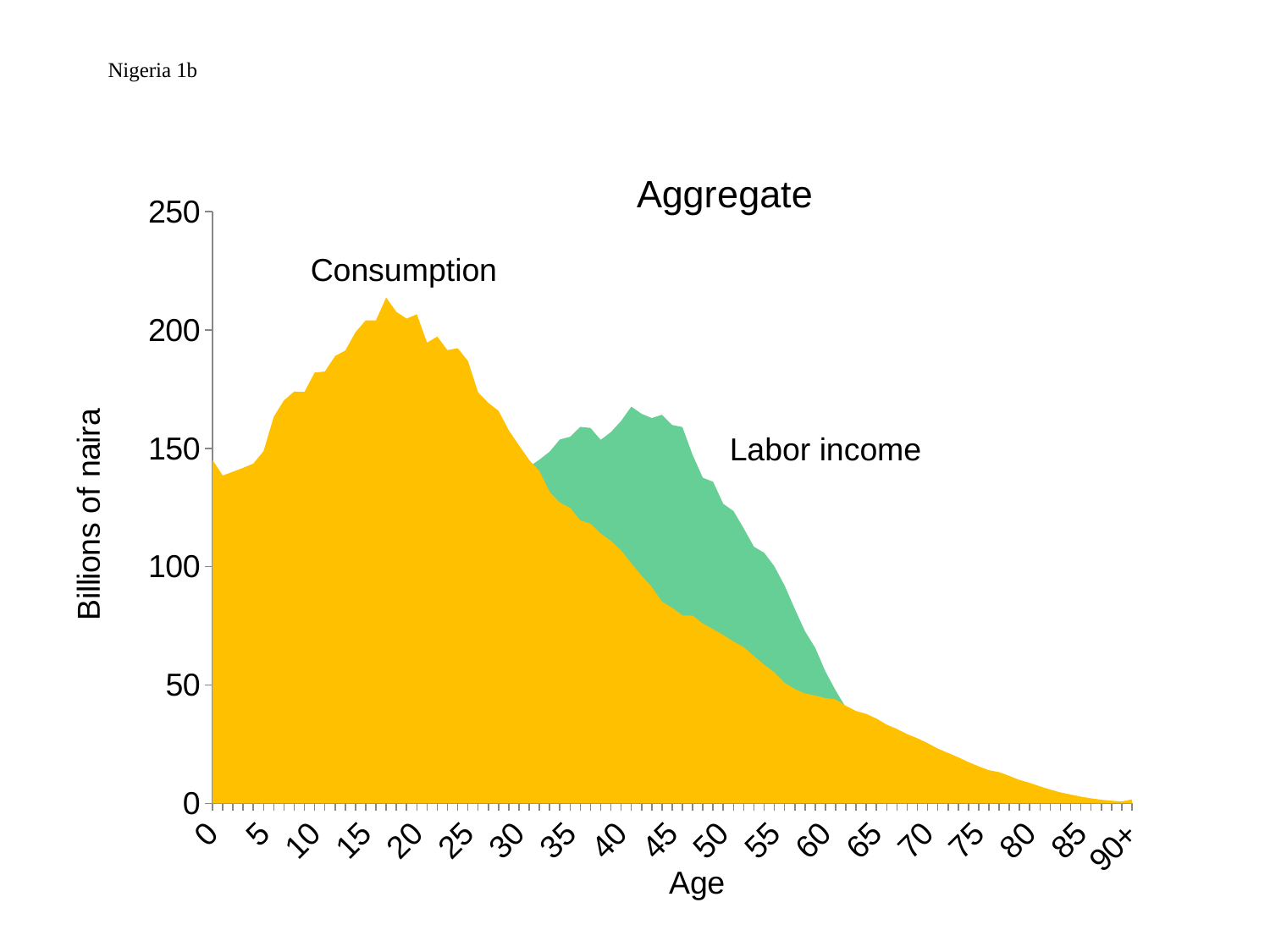
Is the value for Labor income at age 45 greater or less than 100? greater What kind of chart is shown on the slide? Area chart Is the value for Consumption at age 20 greater or less than 150? greater Does Labor income rise or fall along the x axis from age 45 to age 60? fall Is the peak value of Consumption greater or less than 200? greater What is the title of the chart? Aggregate At age 45, which is larger, Consumption or Labor income? Labor income Does Consumption rise or fall along the x axis from age 20 to age 90+? fall What is the label on the vertical axis of the chart? Billions of naira How many data series are labelled on the chart? 2